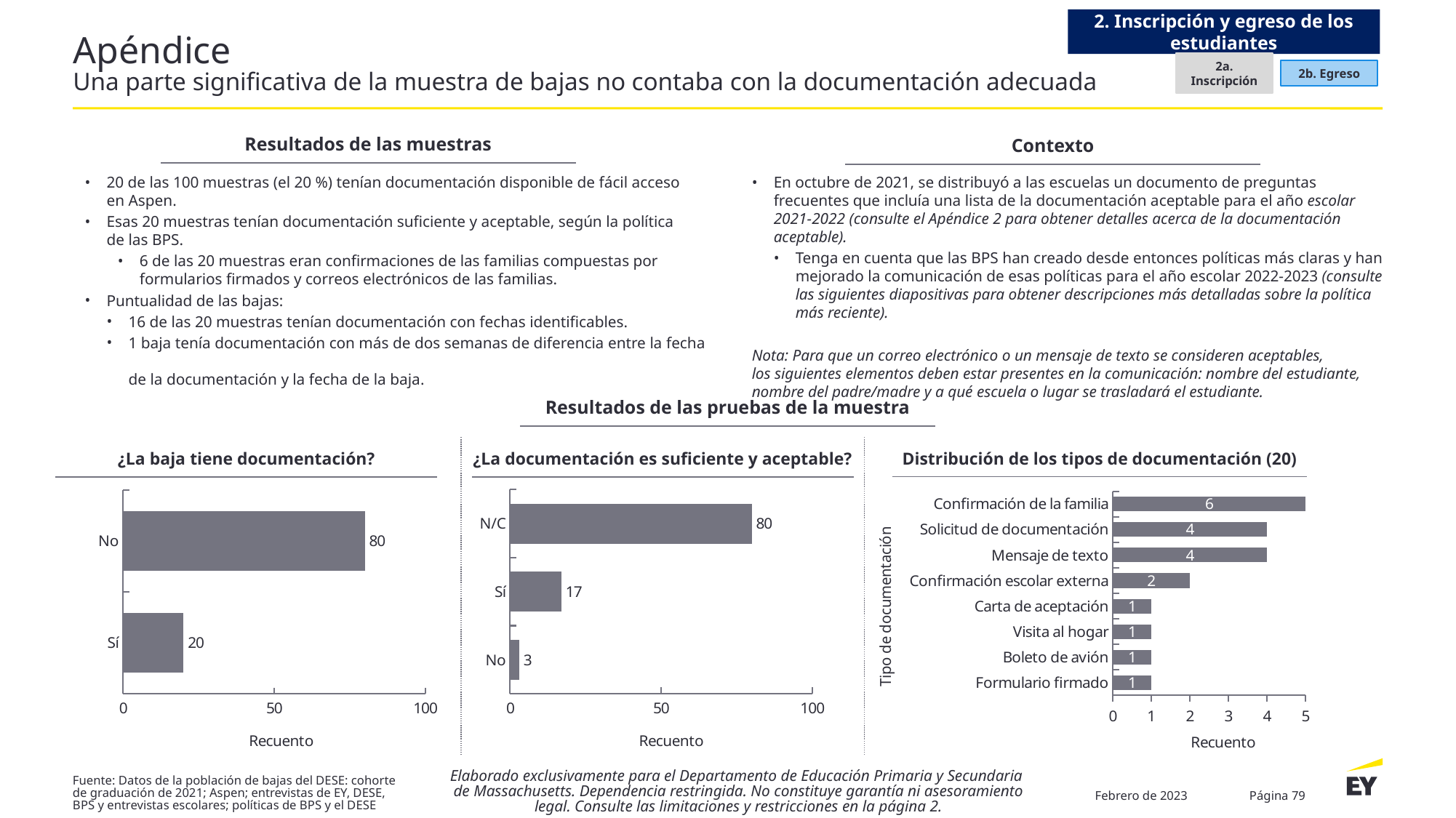
In the chart 'Distribución de los tipos de documentación (20)', what is the value for 'Confirmación escolar externa'? 2 In the chart '¿La baja tiene documentación?', what is the value for 'No'? 80 In the chart '¿La documentación es suficiente y aceptable?', what is the value for 'Sí'? 17 In the chart 'Distribución de los tipos de documentación (20)', which category has the highest value? Confirmación de la familia In the chart 'Distribución de los tipos de documentación (20)', which is larger: 'Solicitud de documentación' or 'Carta de aceptación'? Solicitud de documentación How many categories are shown in the chart '¿La documentación es suficiente y aceptable?'? 3 What kind of chart is '¿La baja tiene documentación?'? bar chart What is the label of the y axis in the chart 'Distribución de los tipos de documentación (20)'? Tipo de documentación In the chart '¿La documentación es suficiente y aceptable?', which category has the lowest value? No In the chart '¿La documentación es suficiente y aceptable?', is the value for 'N/C' greater or less than 50? greater How many categories are shown in the chart 'Distribución de los tipos de documentación (20)'? 8 In the chart '¿La baja tiene documentación?', what is the difference between the 'No' and 'Sí' values? 60